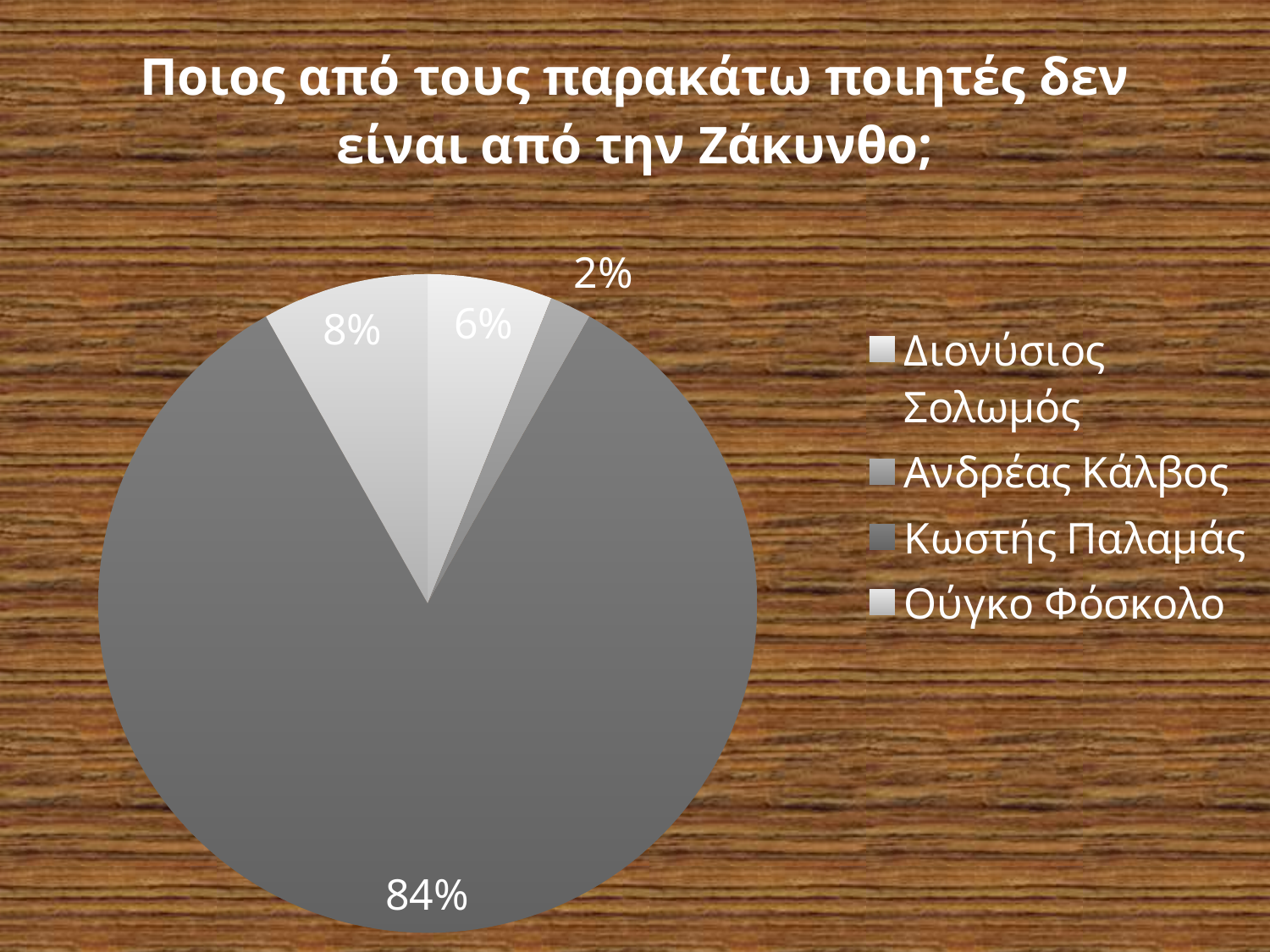
What is the difference in percentage points between Κωστής Παλαμάς and Ούγκο Φόσκολο? 76 What percentage is shown for Ανδρέας Κάλβος? 2% What percentage is shown for Κωστής Παλαμάς? 84% Which has a larger share, Ούγκο Φόσκολο or Διονύσιος Σολωμός? Ούγκο Φόσκολο What percentage is shown for Ούγκο Φόσκολο? 8% What percentage is shown for Διονύσιος Σολωμός? 6% What kind of chart is shown on the slide? pie chart How many entries does the legend list? 4 How many slices does the pie chart have? 4 What is the title of the chart on the slide? Ποιος από τους παρακάτω ποιητές δεν είναι από την Ζάκυνθο; Which poet has the smallest slice of the pie? Ανδρέας Κάλβος Which poet has the largest slice of the pie? Κωστής Παλαμάς